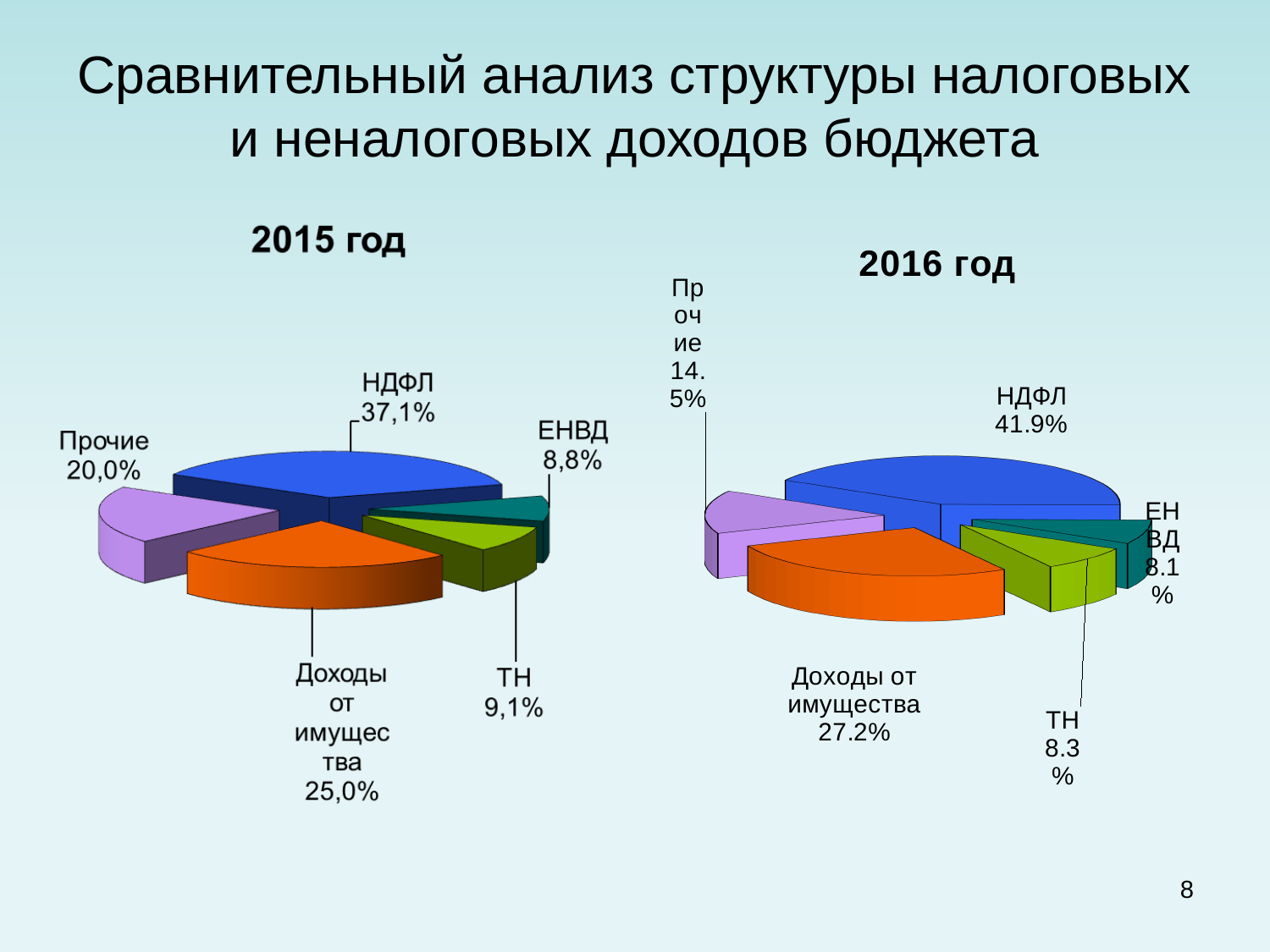
In the 2015 год chart, what colour is the НДФЛ slice? Blue In the 2015 год chart, what is the value for ЕНВД? 8,8% How many slices does the 2016 год pie chart have? 5 In the 2015 год chart, what share does НДФЛ have? 37,1% In the 2016 год chart, which category has the smallest share? ЕНВД In the 2015 год chart, what is the difference between the shares of НДФЛ and Доходы от имущества? 12,1% What type of chart is used for 2015 год? Pie chart In the 2015 год chart, which is larger: Прочие or Доходы от имущества? Доходы от имущества In the 2015 год chart, which category has the smallest share? ЕНВД In the 2016 год chart, what share does Доходы от имущества have? 27.2% In the 2016 год chart, which category has the largest share? НДФЛ In the 2016 год chart, what is the value for Прочие? 14.5%